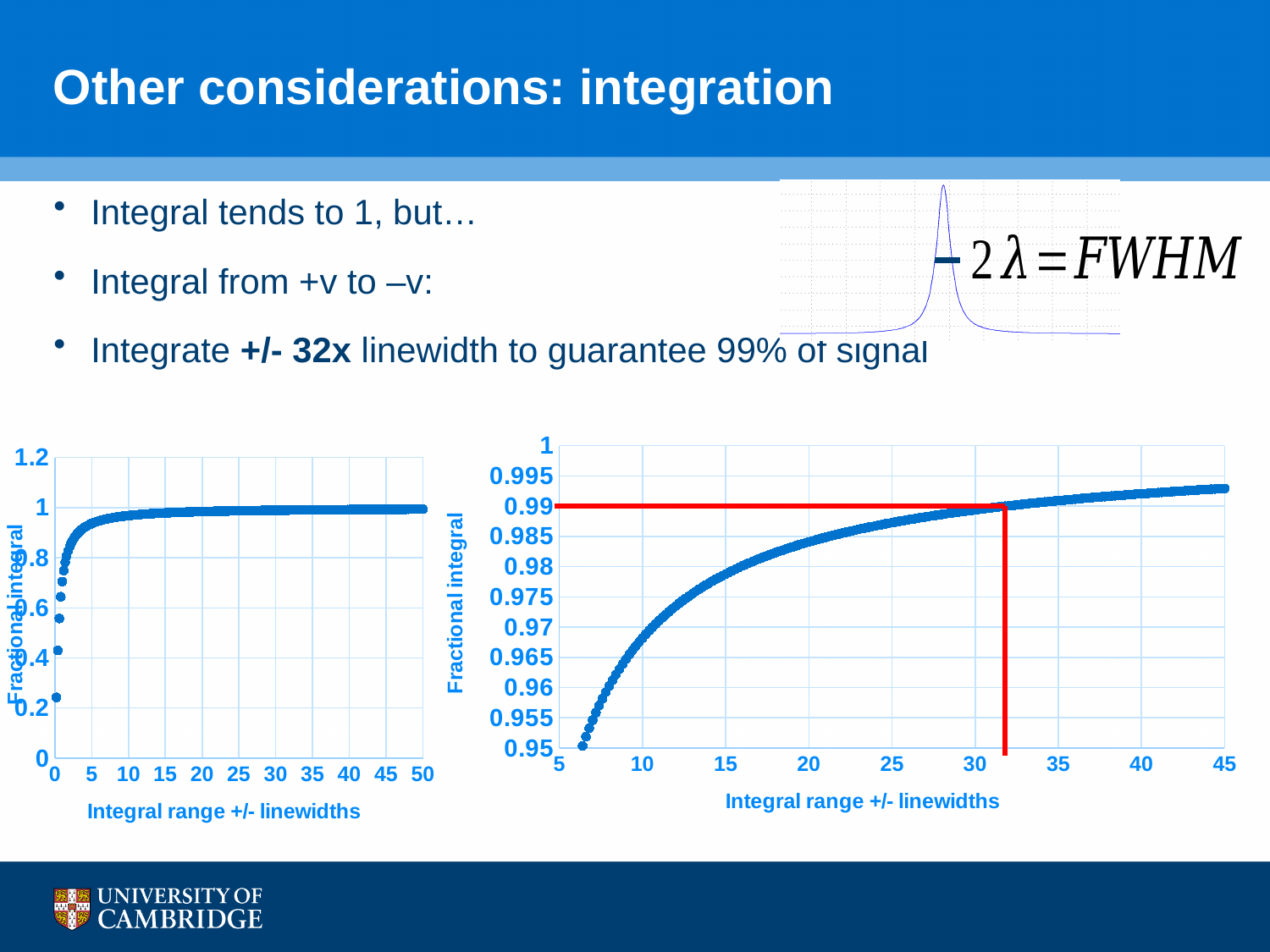
In the right chart, at what fractional integral value is the red horizontal line drawn? 0.99 In the right chart, is the fractional integral at an integral range of 20 linewidths greater or less than 0.98? greater In the right chart, is the fractional integral at an integral range of 40 linewidths greater or less than 0.99? greater In the right chart, is the fractional integral at an integral range of 10 linewidths greater or less than 0.975? less In the left chart, do the values rise or fall as the integral range increases along the x axis? rise What is the y-axis label of the right chart? Fractional integral In the right chart, which has the larger fractional integral: an integral range of 10 linewidths or 45 linewidths? 45 linewidths What kind of chart is the left chart on the slide? scatter chart In the right chart, do the values rise or fall as the integral range increases along the x axis? rise In the left chart, which has the larger fractional integral: an integral range of 1 linewidth or 5 linewidths? 5 linewidths